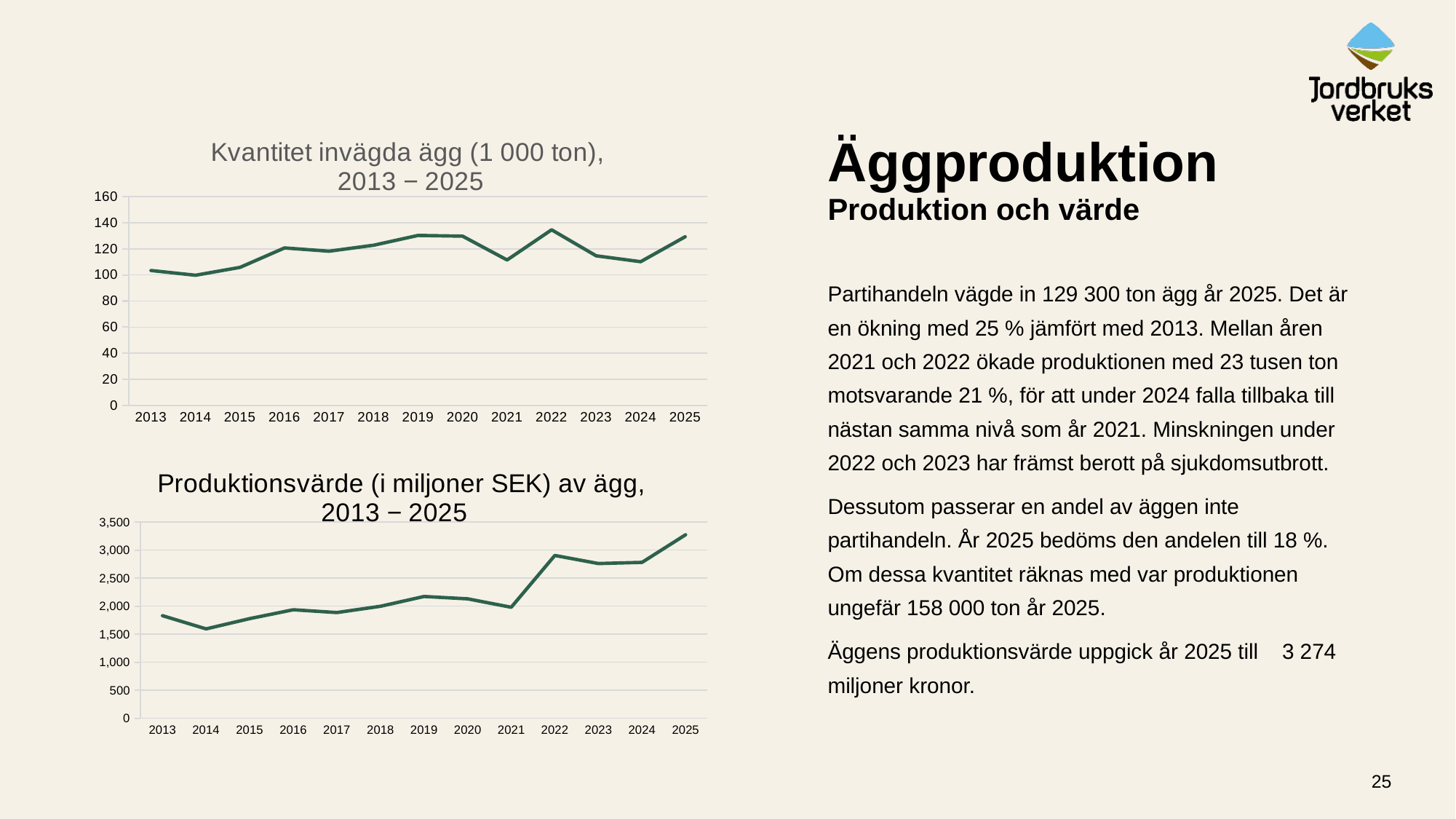
In the bottom chart (Produktionsvärde), is the value for 2025 greater or less than 3,000? greater In the bottom chart (Produktionsvärde), which year has the larger value, 2021 or 2022? 2022 What kind of chart is the bottom chart, "Produktionsvärde (i miljoner SEK) av ägg, 2013 − 2025"? Line chart In the bottom chart (Produktionsvärde), which year has the lowest value? 2014 In the top chart (Kvantitet invägda ägg), how many years are plotted on the x axis? 13 In the top chart (Kvantitet invägda ägg), is the value for 2014 greater or less than 120? less What kind of chart is the top chart, "Kvantitet invägda ägg (1 000 ton), 2013 − 2025"? Line chart In the top chart (Kvantitet invägda ägg), which year has the larger value, 2021 or 2022? 2022 In the bottom chart (Produktionsvärde), do the values overall rise or fall from 2013 to 2025? Rise In the top chart (Kvantitet invägda ägg), is the value for 2022 greater or less than 120? greater In the bottom chart (Produktionsvärde), which year has the highest value? 2025